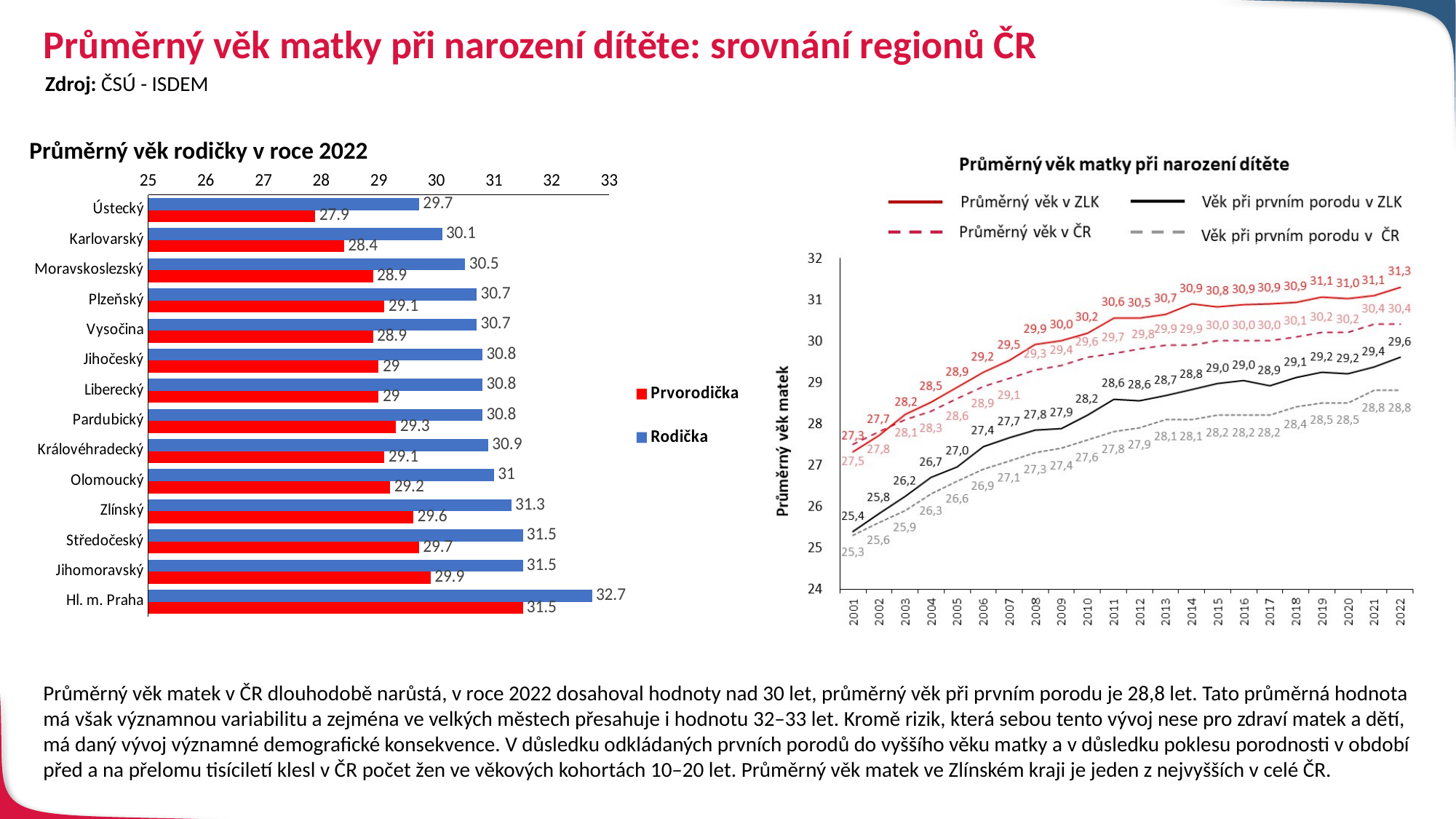
In the bar chart 'Průměrný věk rodičky v roce 2022', what is the difference between the Rodička and Prvorodička values for Karlovarský? 1.7 In the bar chart 'Průměrný věk rodičky v roce 2022', how many regions are listed? 14 In the bar chart 'Průměrný věk rodičky v roce 2022', what is the Prvorodička value for Zlínský? 29.6 In the bar chart 'Průměrný věk rodičky v roce 2022', which region has the highest Rodička value? Hl. m. Praha In the bar chart 'Průměrný věk rodičky v roce 2022', what is the Rodička value for Hl. m. Praha? 32.7 In the bar chart 'Průměrný věk rodičky v roce 2022', which is larger: the Rodička value for Olomoucký or for Moravskoslezský? Olomoucký In the line chart 'Průměrný věk matky při narození dítěte', do the values of 'Věk při prvním porodu v ZLK' generally rise or fall from 2001 to 2022? rise In the bar chart 'Průměrný věk rodičky v roce 2022', is the Prvorodička value for Jihomoravský greater or less than 30? less In the line chart 'Průměrný věk matky při narození dítěte', what is the value of 'Věk při prvním porodu v ČR' in 2001? 25,3 In the line chart 'Průměrný věk matky při narození dítěte', what is the value of 'Průměrný věk v ZLK' in 2022? 31,3 In the bar chart 'Průměrný věk rodičky v roce 2022', which region has the lowest Prvorodička value? Ústecký In the line chart 'Průměrný věk matky při narození dítěte', how many series does the legend list? 4